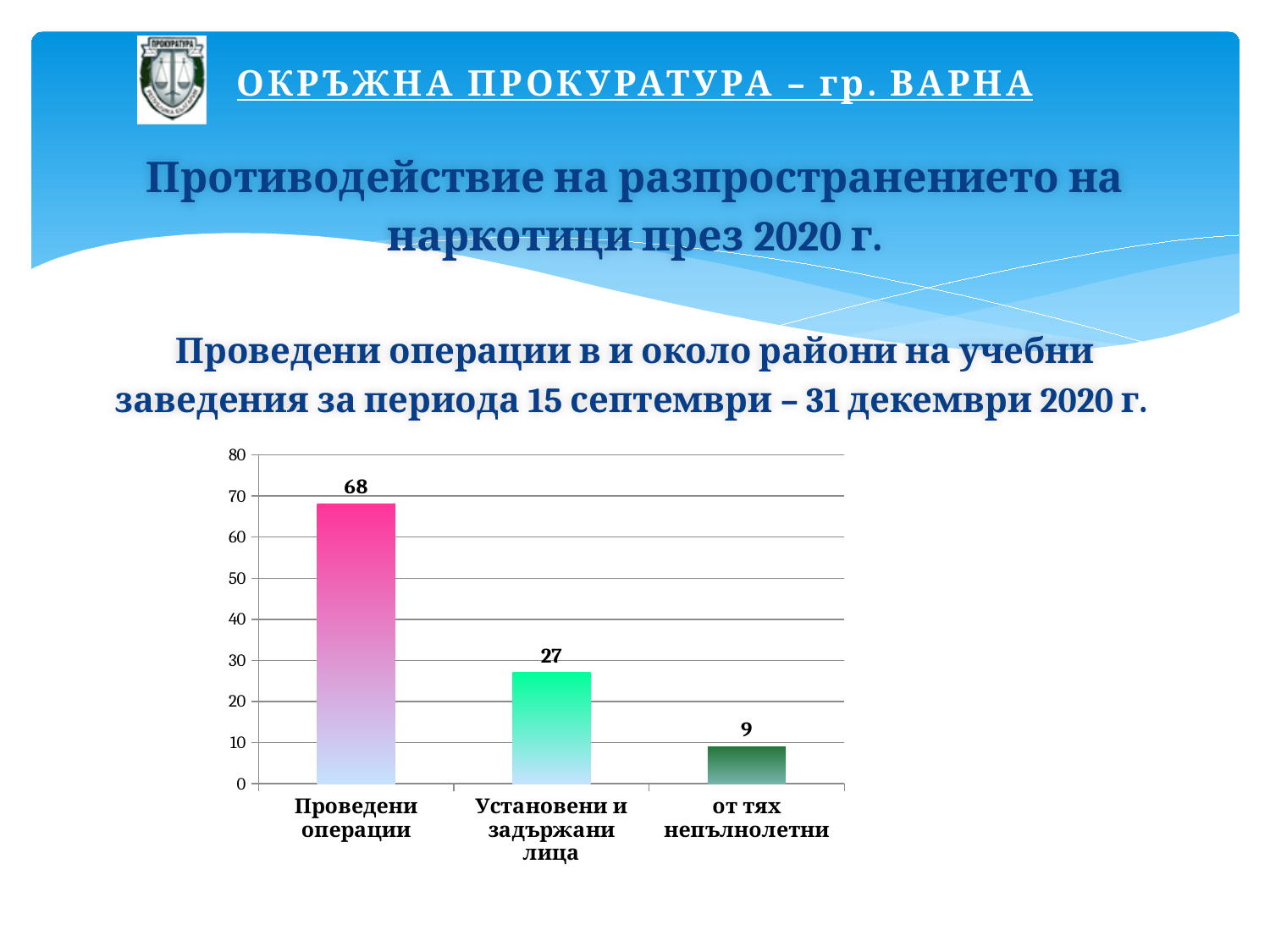
What is the value for "Проведени операции"? 68 Which category has the lowest value? от тях непълнолетни What is the value for "от тях непълнолетни"? 9 Which category has the highest value? Проведени операции What is the difference between the values for "Проведени операции" and "Установени и задържани лица"? 41 How many categories are shown on the chart? 3 Is the value for "Проведени операции" greater or less than 60? greater What is the value for "Установени и задържани лица"? 27 Which is larger: the value for "Установени и задържани лица" or the value for "от тях непълнолетни"? Установени и задържани лица Do the values rise or fall from left to right across the categories? fall What is the difference between the values for "Установени и задържани лица" and "от тях непълнолетни"? 18 What kind of chart is shown on the slide? bar chart